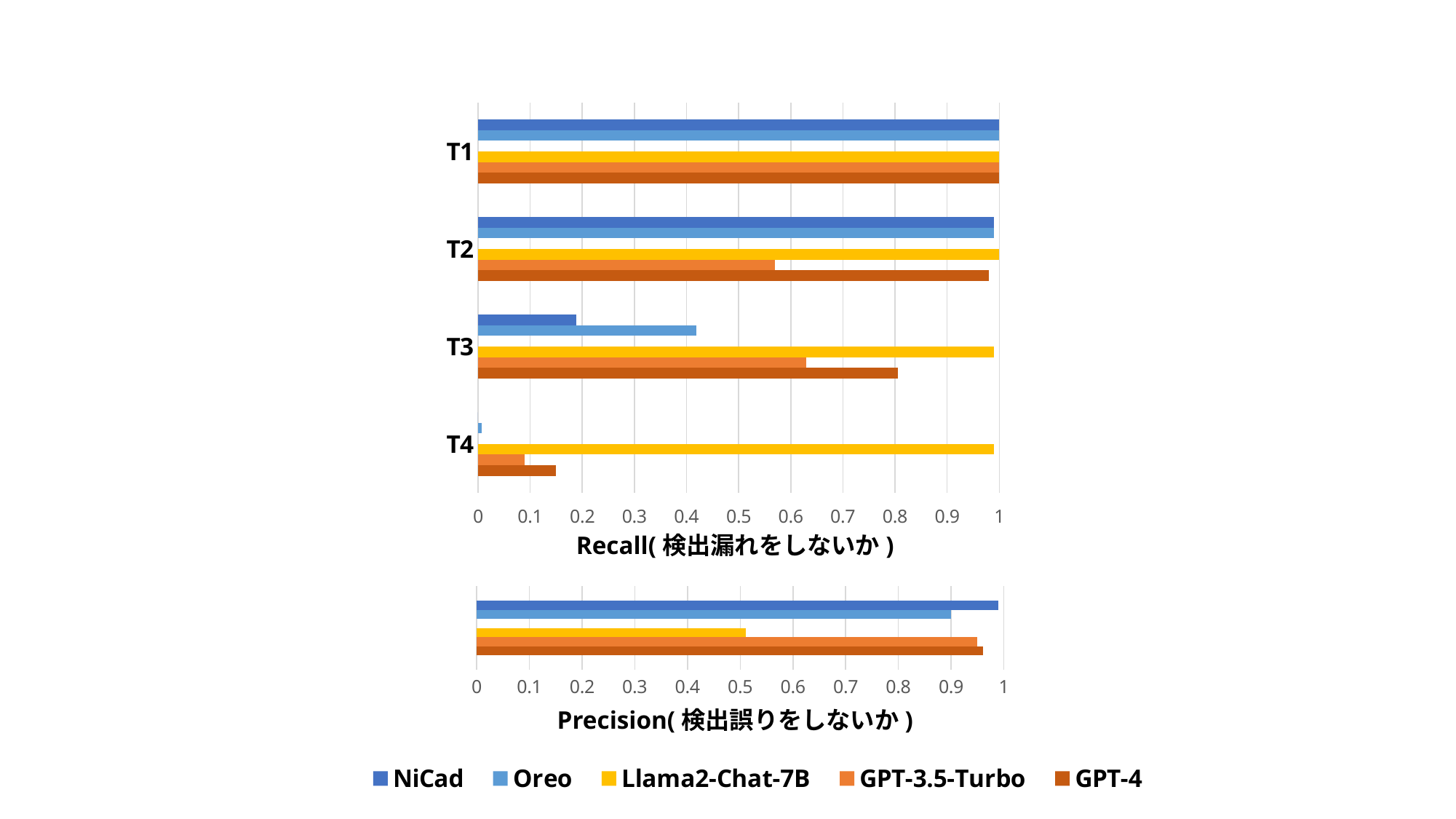
In the Precision chart at the bottom, which series has the lowest value? Llama2-Chat-7B In the Recall chart, which series has the lowest value for T3? NiCad In the Precision chart at the bottom, is the value for Oreo greater or less than 0.8? greater In the Recall chart, is the value for GPT-4 at T4 greater or less than 0.2? less In the Recall chart, is the value for GPT-3.5-Turbo at T3 greater or less than 0.5? greater How many series does the legend list? 5 In the Recall chart, which series has the highest value for T4? Llama2-Chat-7B In the Recall chart, which series has the lowest value for T2? GPT-3.5-Turbo In the Recall chart, how many categories (T1–T4) are shown on the vertical axis? 4 What kind of chart is the Recall chart at the top of the slide? bar chart In the Recall chart, which is larger for T3: Oreo or NiCad? Oreo In the Recall chart, which series has the highest value for T3? Llama2-Chat-7B